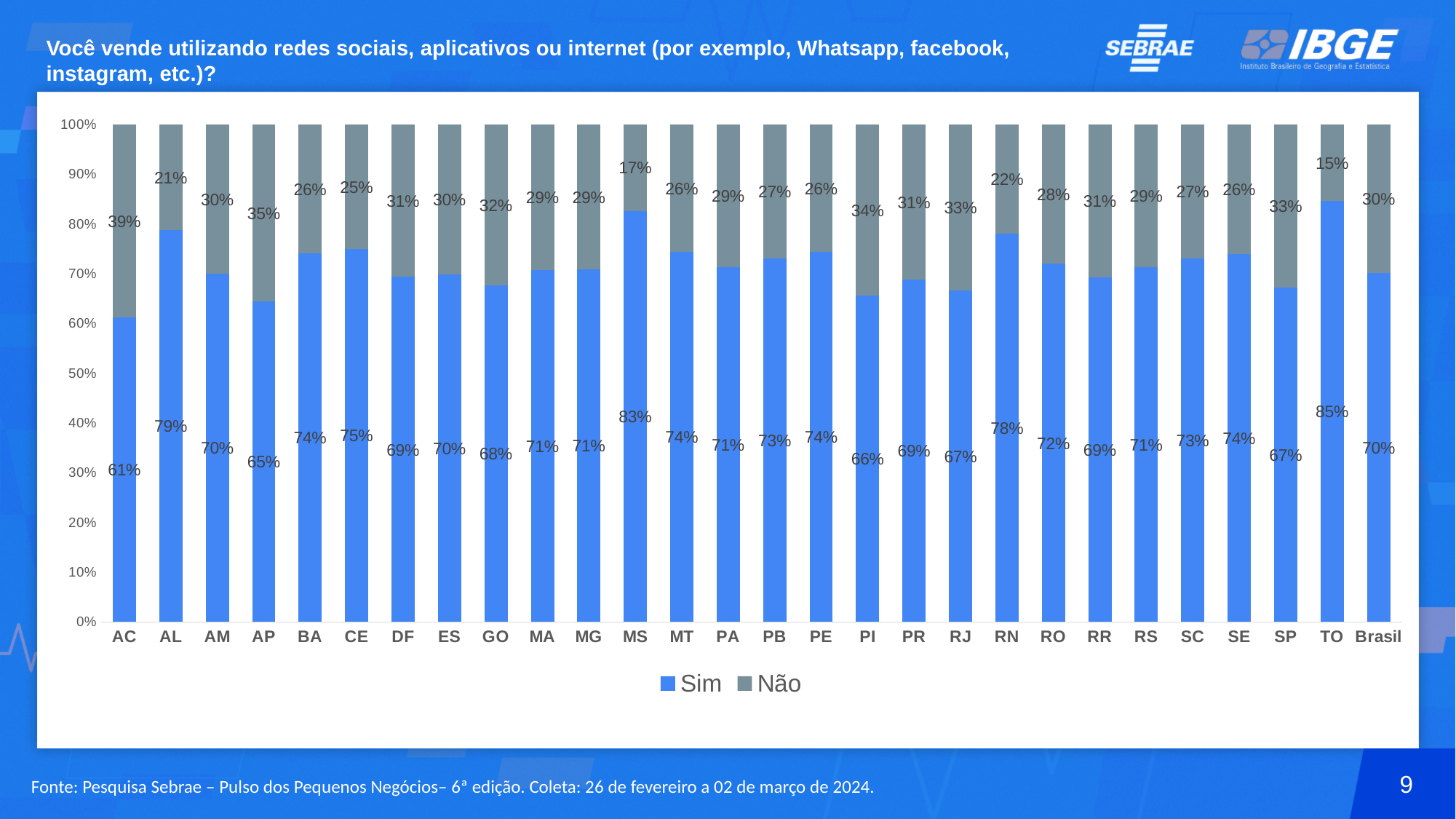
How many categories are shown on the x axis? 28 What kind of chart is shown on the slide? Stacked bar chart What is the difference between the "Sim" values for TO and AC? 24% What is the "Sim" value for MS? 83% What is the "Sim" value for Brasil? 70% What is the "Não" value for AP? 35% Which category has the lowest "Sim" value? AC What are the two series named in the legend? Sim and Não Which category has the highest "Sim" value? TO Which category has the highest "Não" value? AC How many series does the legend list? 2 Which is larger, the "Sim" value for AL or the "Sim" value for RN? AL